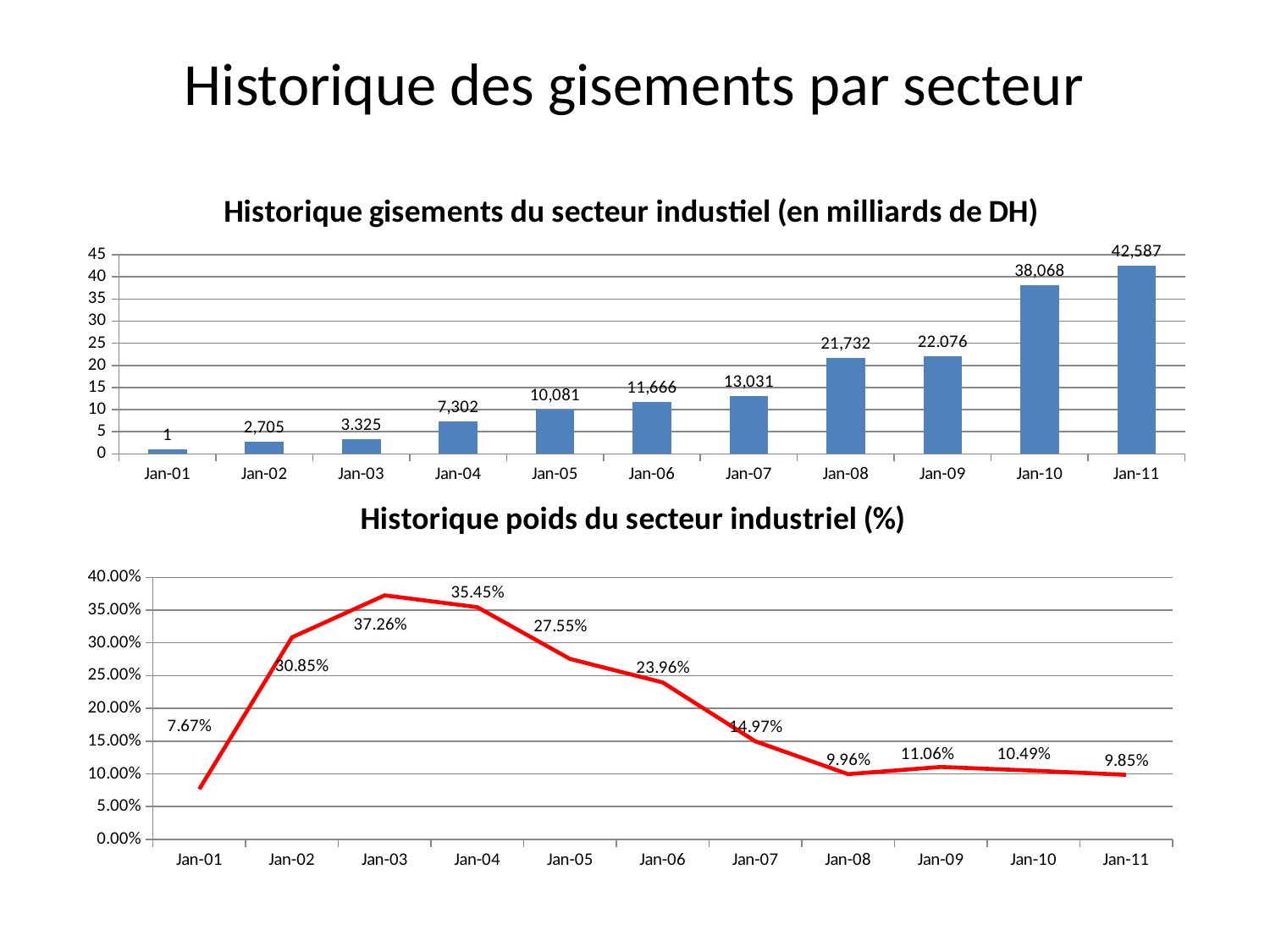
In the top bar chart, what is the difference between the values for Jan-11 and Jan-10? 4,519 In the bottom line chart, which is larger, the value for Jan-09 or the value for Jan-11? Jan-09 In the top bar chart, what is the value for Jan-04? 7,302 In the bottom line chart, what is the value for Jan-03? 37.26% In the top bar chart, which year has the lowest value? Jan-01 In the top bar chart, how many bars are plotted? 11 In the bottom line chart, what is the difference between the values for Jan-03 and Jan-01? 29.59% In the top bar chart, do the values generally rise or fall from Jan-01 to Jan-11? rise What type of chart is the top chart, 'Historique gisements du secteur industiel (en milliards de DH)'? bar chart What type of chart is the bottom chart, 'Historique poids du secteur industriel (%)'? line chart In the top bar chart, what is the value for Jan-11? 42,587 In the bottom line chart, which year has the highest value? Jan-03